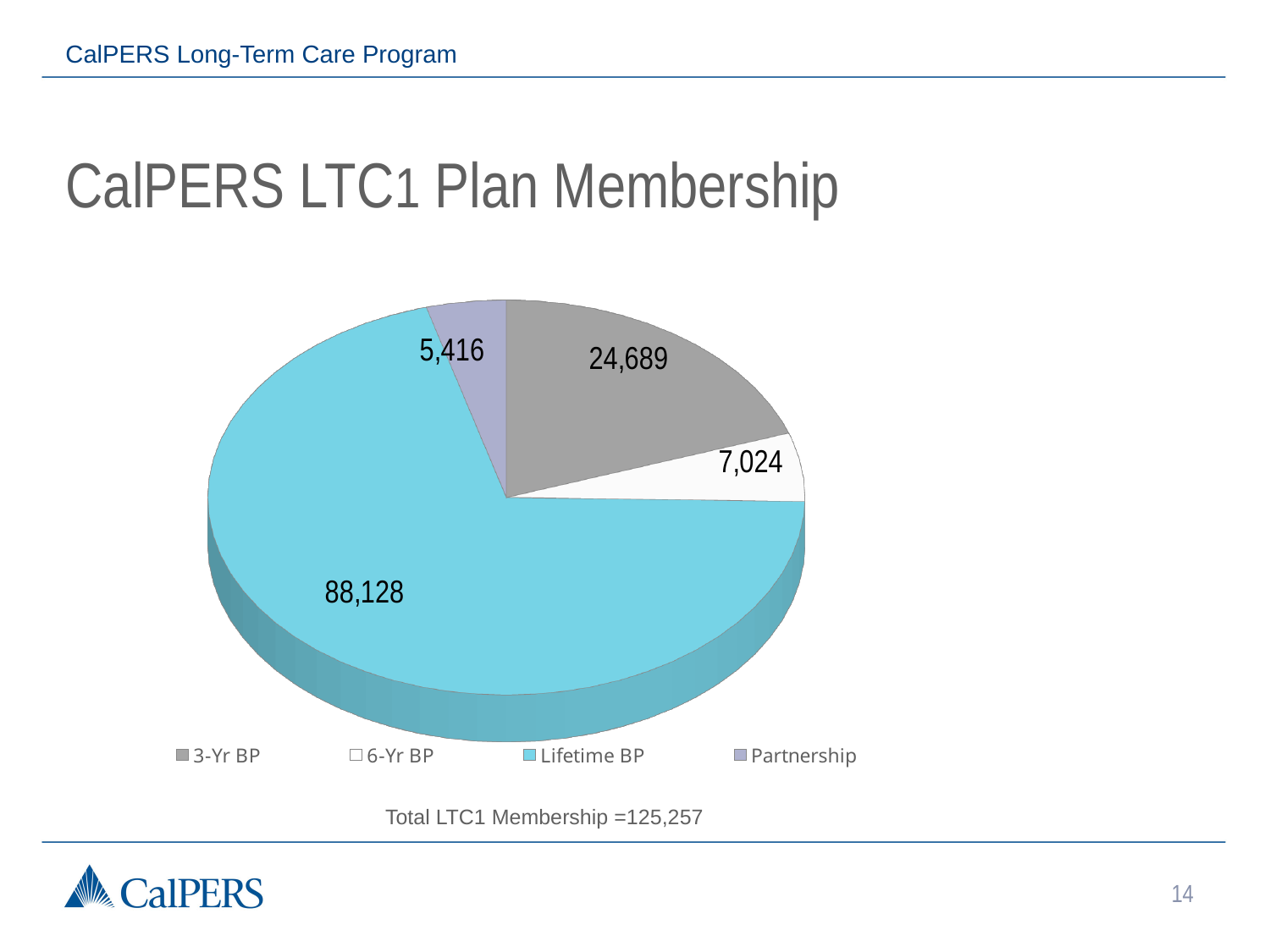
Which plan category has the largest membership? Lifetime BP What is the membership value for 3-Yr BP? 24,689 What is the difference in membership between Lifetime BP and 3-Yr BP? 63,439 What is the membership value for Lifetime BP? 88,128 Which plan category has the smallest membership? Partnership What is the membership value for Partnership? 5,416 How many categories does the pie chart show? 4 What type of chart is shown on the slide? Pie chart What is the total LTC1 membership stated on the slide? 125,257 What is the membership value for 6-Yr BP? 7,024 What is the difference in membership between 6-Yr BP and Partnership? 1,608 Which has more members, 3-Yr BP or 6-Yr BP? 3-Yr BP